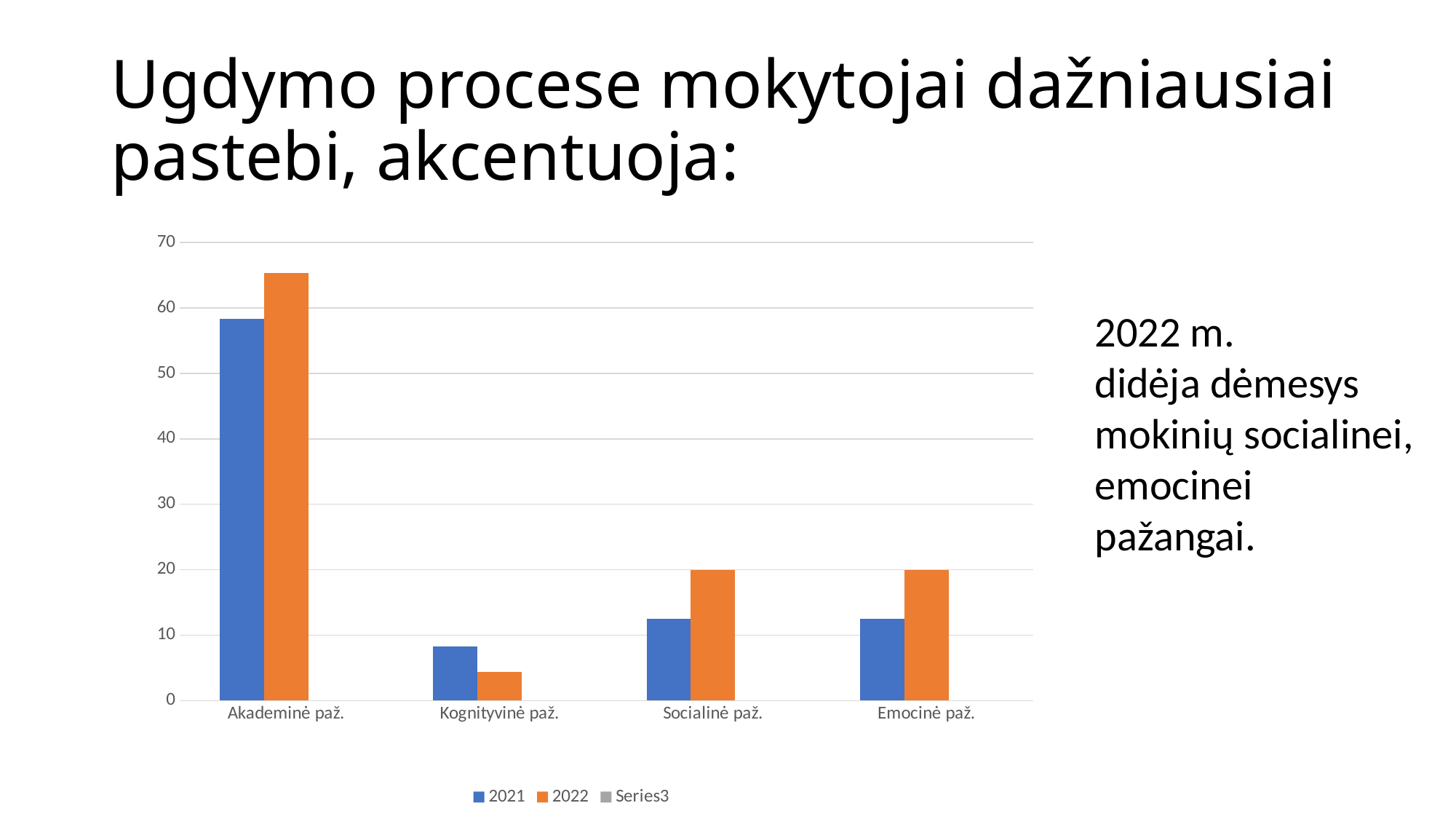
How many series does the chart legend list? 3 How many categories are shown on the x axis of the chart? 4 For Akademinė paž., which series has the larger value, 2021 or 2022? 2022 Is the 2021 value for Socialinė paž. greater or less than 20? less Which category has the highest value for the 2022 series? Akademinė paž. For Kognityvinė paž., which series has the larger value, 2021 or 2022? 2021 Which category has the lowest value for the 2021 series? Kognityvinė paž. Which series is shown in orange in the chart legend? 2022 Is the 2021 value for Akademinė paž. greater or less than 50? greater What kind of chart is shown on the slide? bar chart Is the 2022 value for Kognityvinė paž. greater or less than 10? less Which category has the lowest value for the 2022 series? Kognityvinė paž.